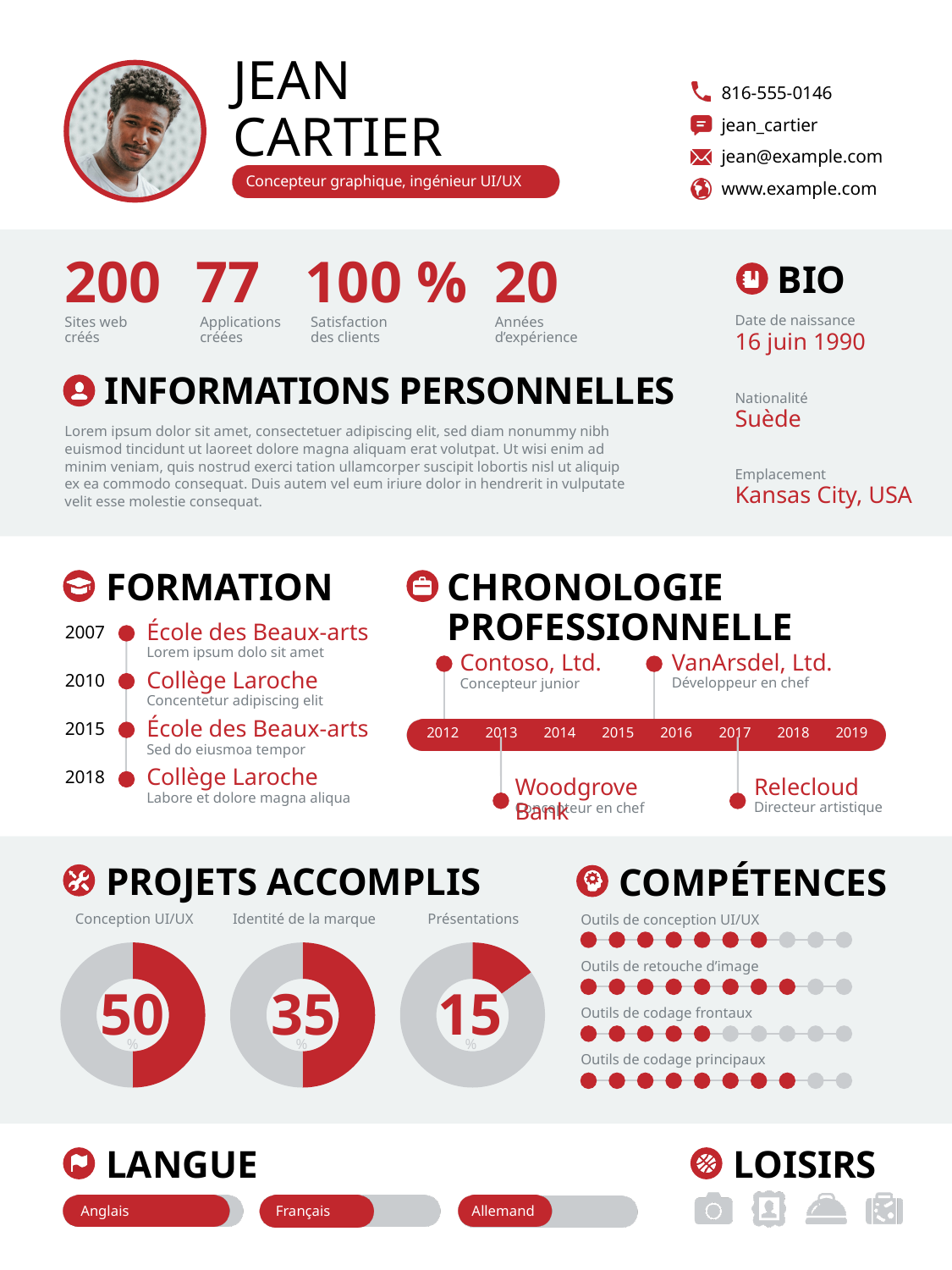
In the Projets accomplis section, what is the difference between the Conception UI/UX value and the Présentations value? 35% In the Projets accomplis section, what value is shown in the Identité de la marque donut chart? 35% Among the three Projets accomplis donut charts, which category has the lowest value? Présentations In the Projets accomplis section, what value is shown in the Présentations donut chart? 15% Among the three Projets accomplis donut charts, which category has the highest value? Conception UI/UX In the Compétences section, how many of the ten dots are filled red for Outils de codage frontaux? 5 In the Projets accomplis section, which is larger: the Identité de la marque value or the Présentations value? Identité de la marque What kind of chart is used in the Projets accomplis section? Donut chart In the Projets accomplis donut charts, what colour is used for the filled (value) portion? Red In the Projets accomplis section, what value is shown in the Conception UI/UX donut chart? 50% How many donut charts are shown in the Projets accomplis section? 3 In the Projets accomplis section, what is the difference between the Identité de la marque value and the Présentations value? 20%